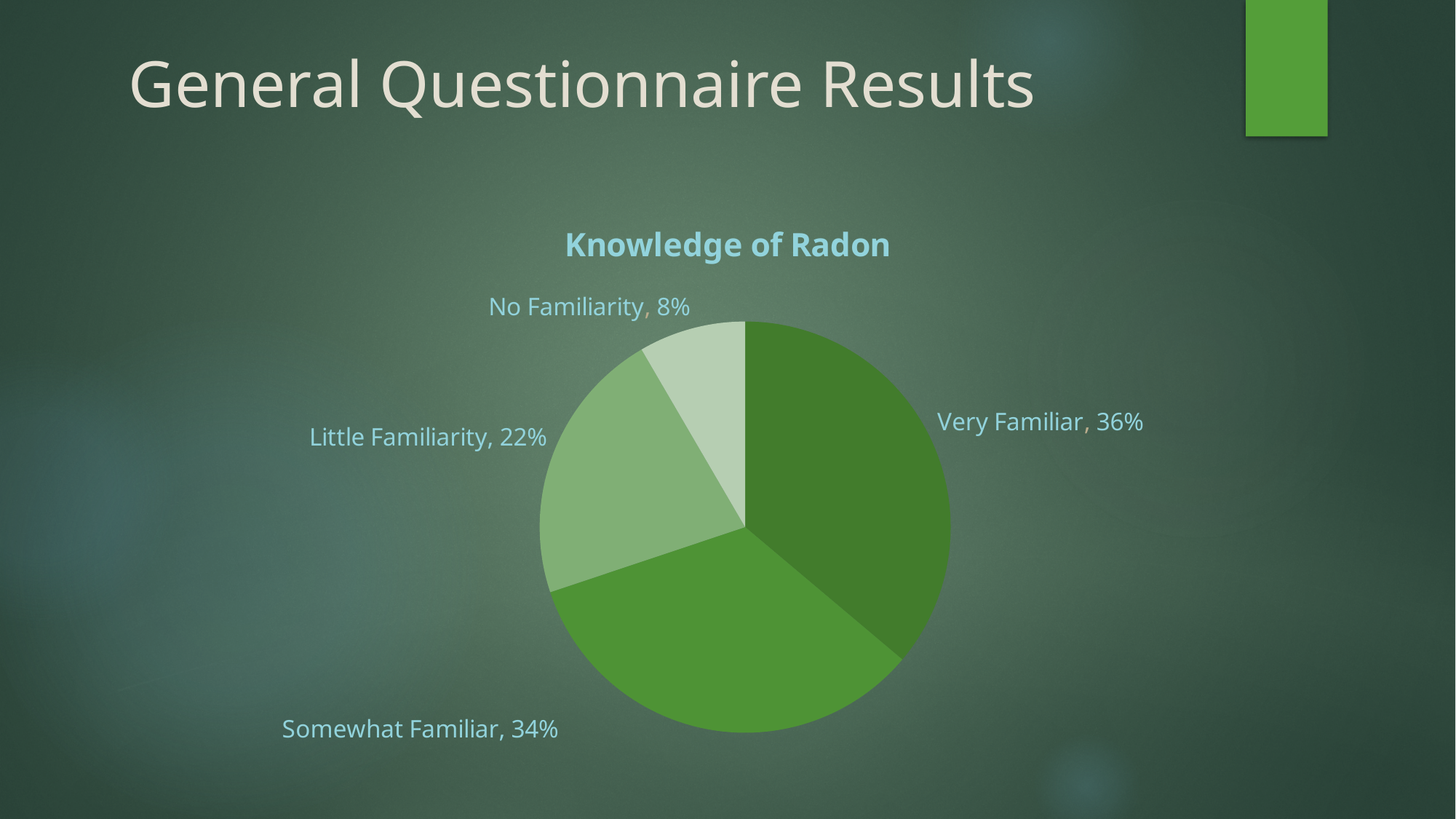
What percentage of respondents were Somewhat Familiar? 34% Which is larger, the share for Little Familiarity or the share for No Familiarity? Little Familiarity How many categories are shown in the pie chart? 4 Which category has the smallest share of the pie? No Familiarity What percentage of respondents reported No Familiarity with radon? 8% What percentage of respondents reported Little Familiarity? 22% What is the difference in percentage points between Somewhat Familiar and Little Familiarity? 12 What is the difference in percentage points between Very Familiar and No Familiarity? 28 Which category has the largest share of the pie? Very Familiar What is the title of the chart? Knowledge of Radon What percentage of respondents were Very Familiar with radon? 36% What type of chart is shown on the slide? pie chart